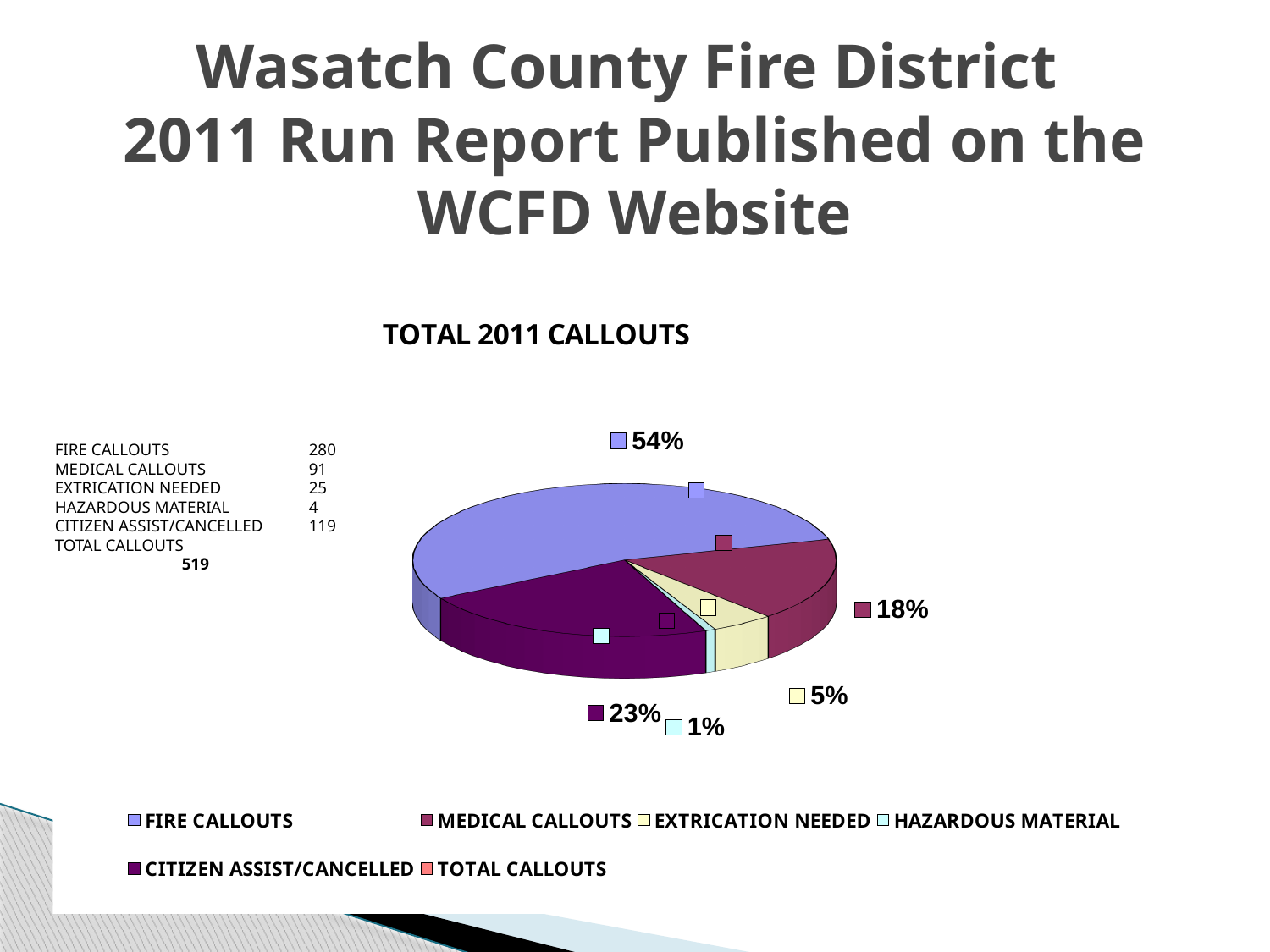
Which slice is larger, MEDICAL CALLOUTS or CITIZEN ASSIST/CANCELLED? CITIZEN ASSIST/CANCELLED What percentage of the pie is HAZARDOUS MATERIAL? 1% How many entries does the chart's legend list? 6 Which category has the largest slice of the pie? FIRE CALLOUTS What is the difference in percentage points between the FIRE CALLOUTS slice and the CITIZEN ASSIST/CANCELLED slice? 31 What percentage of the pie is MEDICAL CALLOUTS? 18% What percentage of the pie is CITIZEN ASSIST/CANCELLED? 23% What is the chart's title? TOTAL 2011 CALLOUTS What type of chart is shown on the slide? pie chart Which category has the smallest slice of the pie? HAZARDOUS MATERIAL